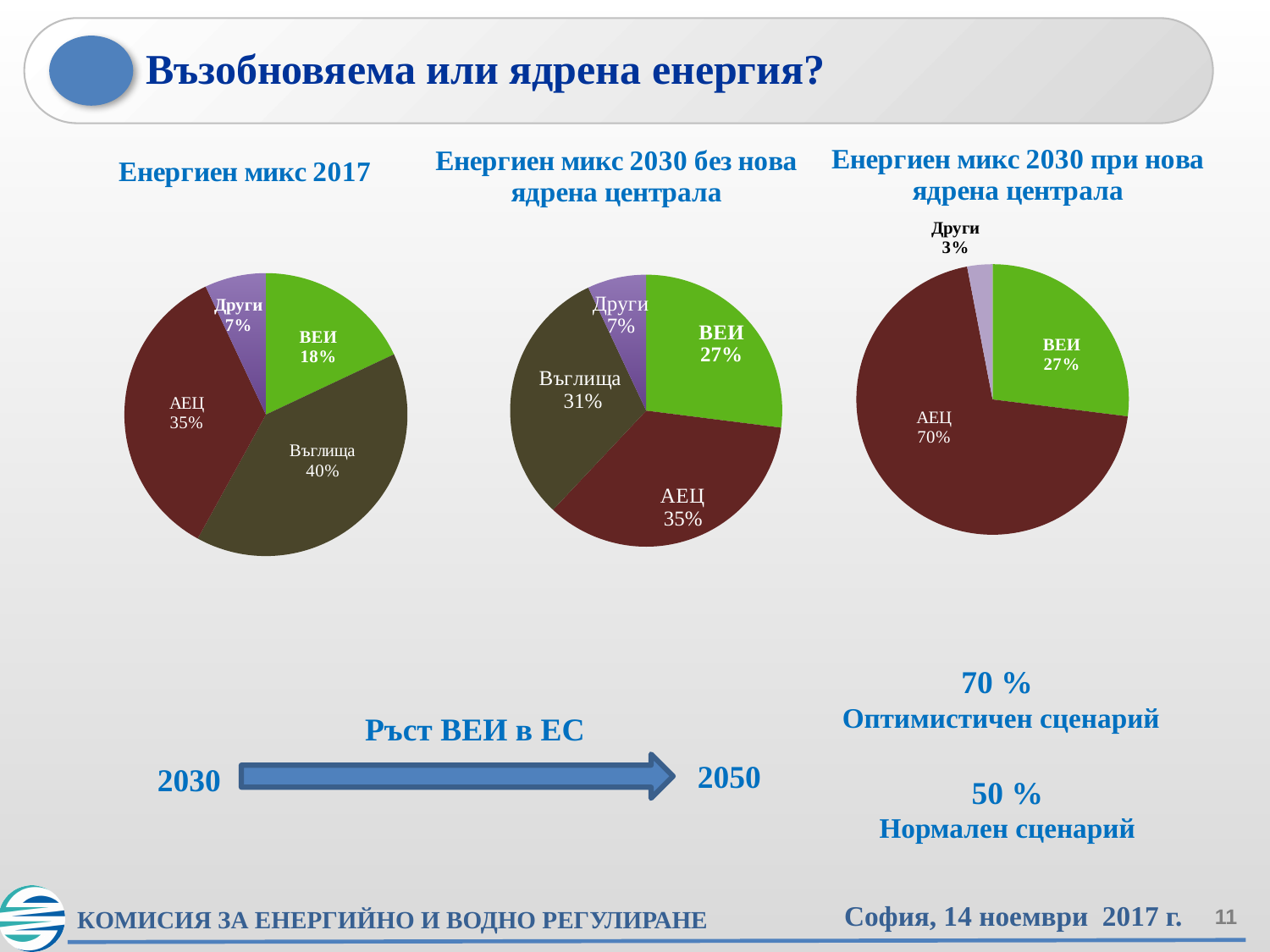
In the chart titled "Енергиен микс 2030 при нова ядрена централа", what share does АЕЦ have? 70% Which is larger: the share of ВЕИ in the chart titled "Енергиен микс 2017" or the share of ВЕИ in the chart titled "Енергиен микс 2030 без нова ядрена централа"? Енергиен микс 2030 без нова ядрена централа In the chart titled "Енергиен микс 2017", what is the difference between the shares of АЕЦ and ВЕИ? 17% In the chart titled "Енергиен микс 2017", which category has the largest share? Въглища In the chart titled "Енергиен микс 2030 при нова ядрена централа", what share does Други have? 3% In the chart titled "Енергиен микс 2030 без нова ядрена централа", how many slices does the pie have? 4 What type of chart is the chart titled "Енергиен микс 2017"? Pie chart In the chart titled "Енергиен микс 2017", which category has the smallest share? Други In the chart titled "Енергиен микс 2030 без нова ядрена централа", which category has the largest share? АЕЦ In the chart titled "Енергиен микс 2030 при нова ядрена централа", how many slices does the pie have? 3 In the chart titled "Енергиен микс 2030 без нова ядрена централа", what share does ВЕИ have? 27% In the chart titled "Енергиен микс 2017", what share does Въглища have? 40%